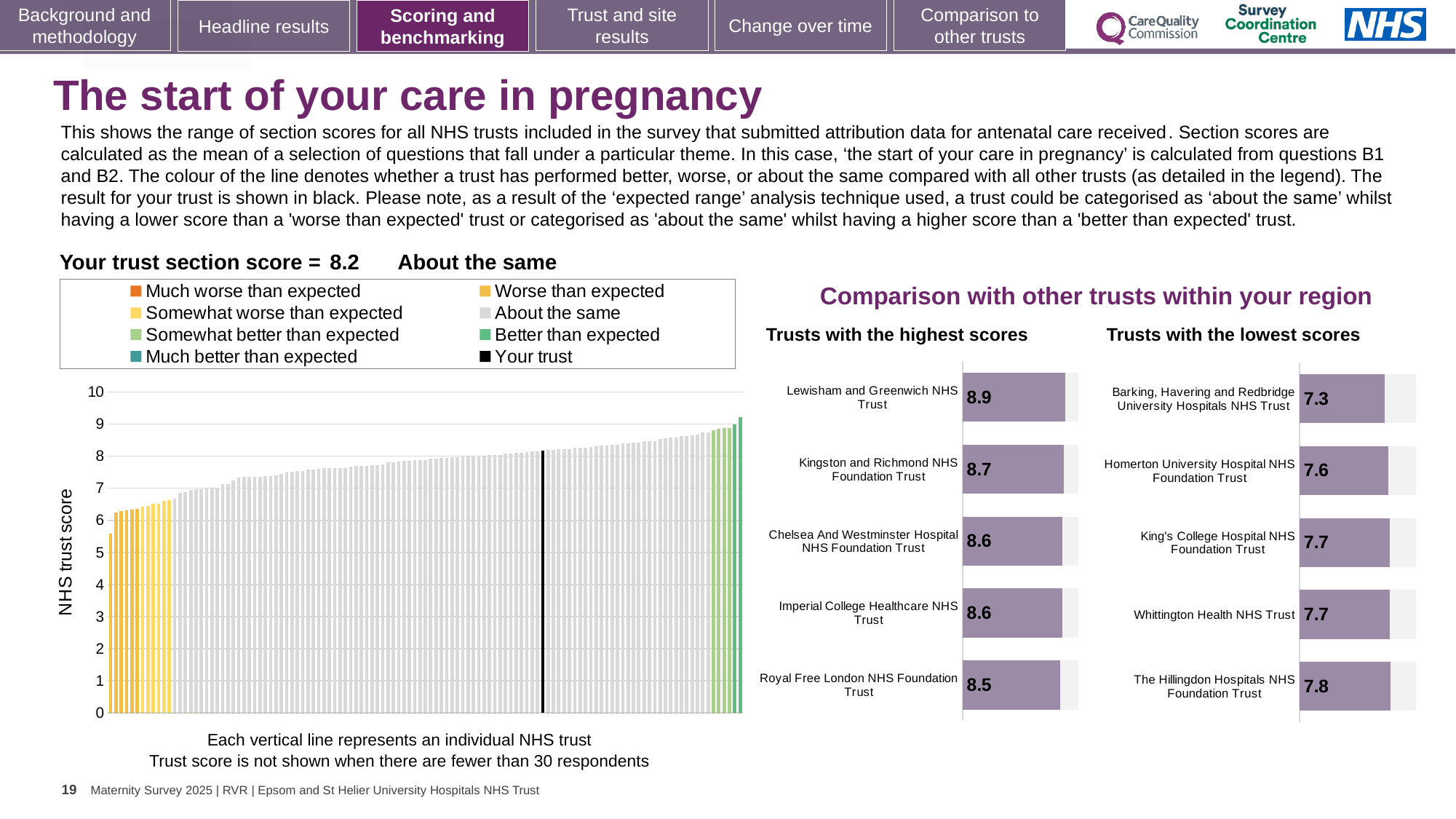
In the 'Trusts with the lowest scores' chart, which trust has the lowest score? Barking, Havering and Redbridge University Hospitals NHS Trust In the 'Trusts with the highest scores' chart, which trust has the highest score? Lewisham and Greenwich NHS Trust In the main 'NHS trust score' chart, what is the section score for your trust (the black line)? 8.2 In the 'Trusts with the highest scores' chart, what is the score for Lewisham and Greenwich NHS Trust? 8.9 In the main 'NHS trust score' chart, is the value of the leftmost (lowest) bar greater or less than 6? less In the 'Trusts with the highest scores' chart, what is the score for Kingston and Richmond NHS Foundation Trust? 8.7 How many entries does the legend above the main 'NHS trust score' chart list? 8 In the main 'NHS trust score' chart, do the values rise or fall from left to right along the x axis? rise In the 'Trusts with the lowest scores' chart, what is the score for Barking, Havering and Redbridge University Hospitals NHS Trust? 7.3 How many trusts are shown in the 'Trusts with the lowest scores' chart? 5 In the 'Trusts with the lowest scores' chart, which has the larger score: Homerton University Hospital NHS Foundation Trust or The Hillingdon Hospitals NHS Foundation Trust? The Hillingdon Hospitals NHS Foundation Trust In the 'Trusts with the highest scores' chart, what is the difference between the scores of Lewisham and Greenwich NHS Trust and Royal Free London NHS Foundation Trust? 0.4